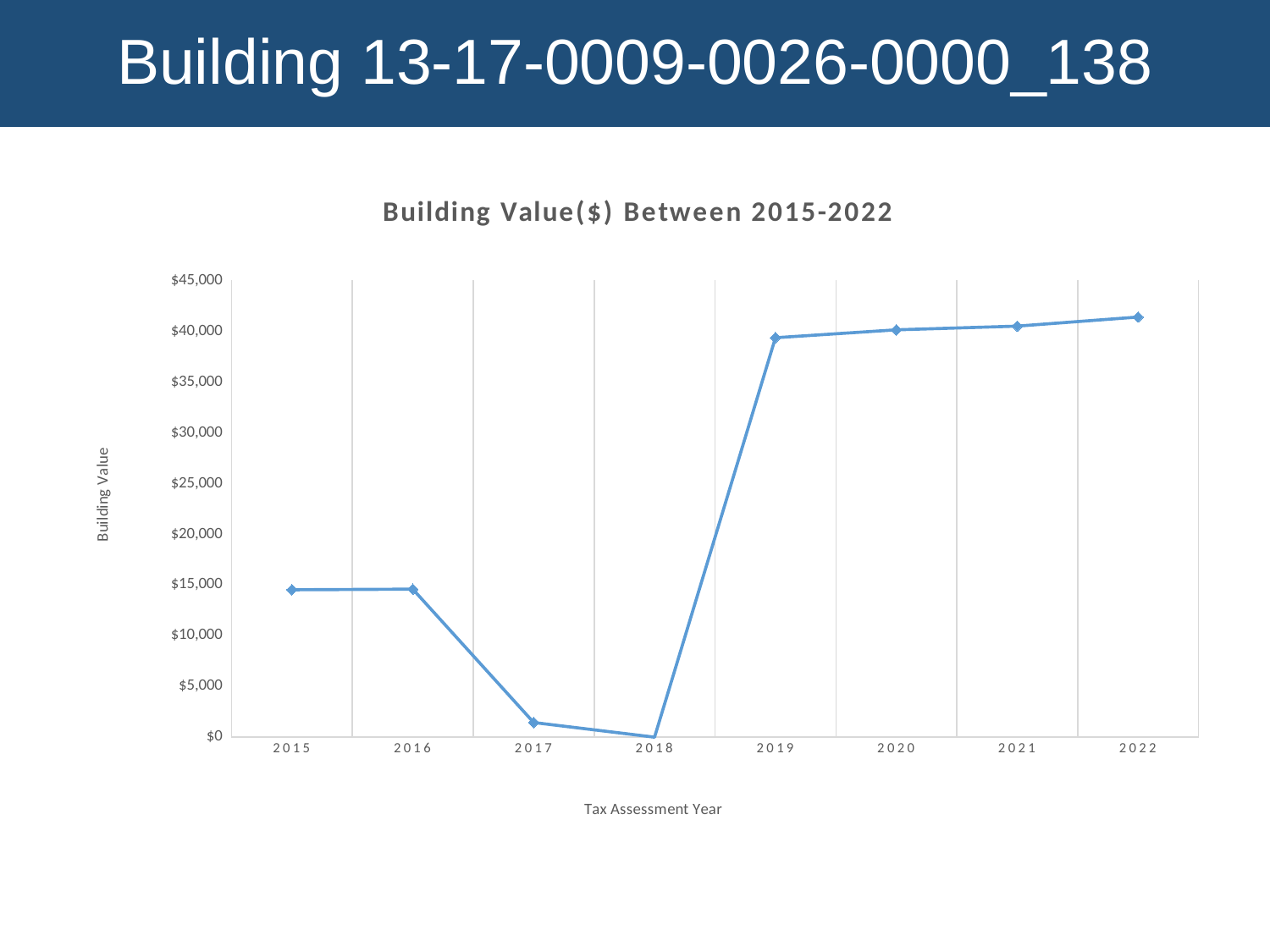
Which year has the larger building value, 2015 or 2017? 2015 What kind of chart is shown on the slide? line chart How many years are plotted on the x axis? 8 Does the building value rise or fall from 2018 to 2022? rise Is the building value for 2019 greater or less than $35,000? greater Which year has the larger building value, 2016 or 2019? 2019 What is the title of the chart? Building Value($) Between 2015-2022 Which year has the lowest building value? 2018 What is the label of the x axis? Tax Assessment Year Is the building value for 2017 greater or less than $5,000? less Is the building value for 2016 greater or less than $10,000? greater